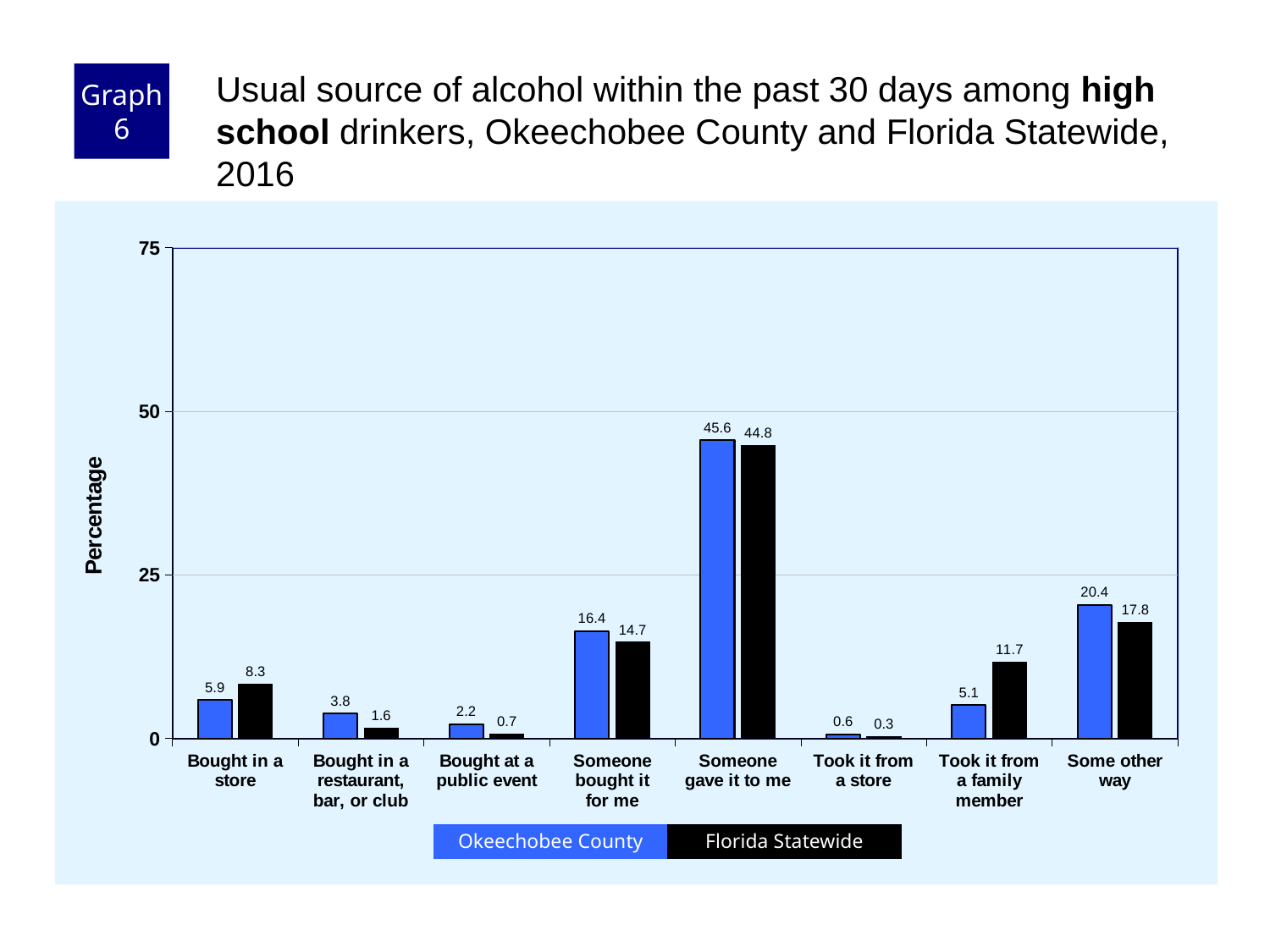
Which category has the highest Florida Statewide value? Someone gave it to me What is the label of the y axis? Percentage Which category has the lowest Okeechobee County value? Took it from a store What is the difference between the Okeechobee County and Florida Statewide values for "Took it from a family member"? 6.6 What is the Florida Statewide value for "Took it from a family member"? 11.7 Is the Okeechobee County value for "Some other way" greater or less than 25? less How many source categories are shown on the x axis? 8 What is the Okeechobee County value for "Bought in a restaurant, bar, or club"? 3.8 Which is larger for "Bought in a store": Okeechobee County or Florida Statewide? Florida Statewide How many series does the legend list? 2 What kind of chart is shown on the slide? bar chart What is the Okeechobee County value for "Someone gave it to me"? 45.6